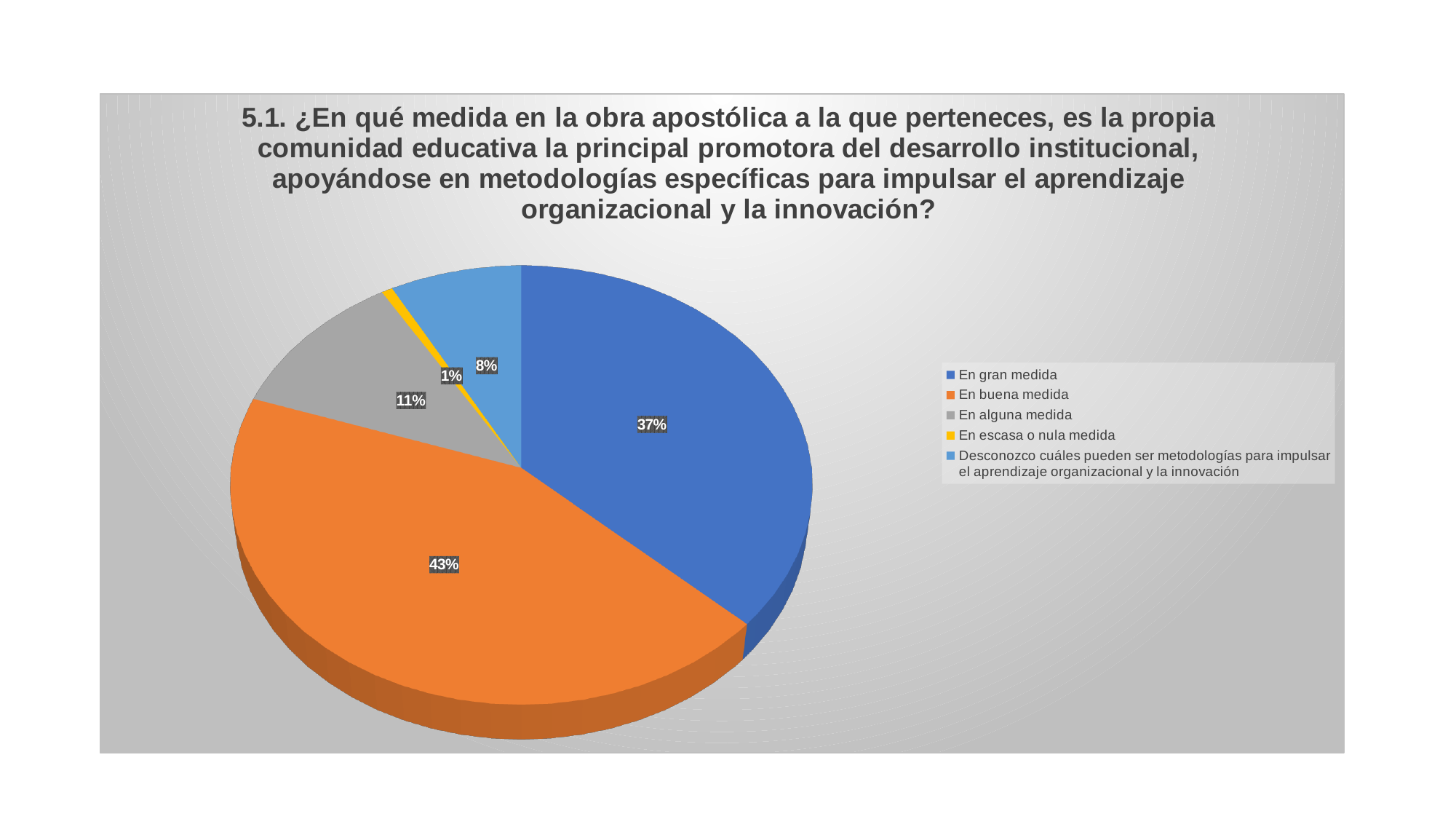
What share of the pie does "En alguna medida" represent? 11% Which category has the smallest slice of the pie? En escasa o nula medida What colour is the slice for "En escasa o nula medida"? Yellow What share of the pie does "Desconozco cuáles pueden ser metodologías para impulsar el aprendizaje organizacional y la innovación" represent? 8% Which is larger, the share for "En alguna medida" or the share for "Desconozco cuáles pueden ser metodologías para impulsar el aprendizaje organizacional y la innovación"? En alguna medida What kind of chart is shown on the slide? Pie chart What share of the pie does "En gran medida" represent? 37% Which category has the largest slice of the pie? En buena medida How many categories does the pie chart show? 5 What is the difference in percentage points between "En buena medida" and "En gran medida"? 6